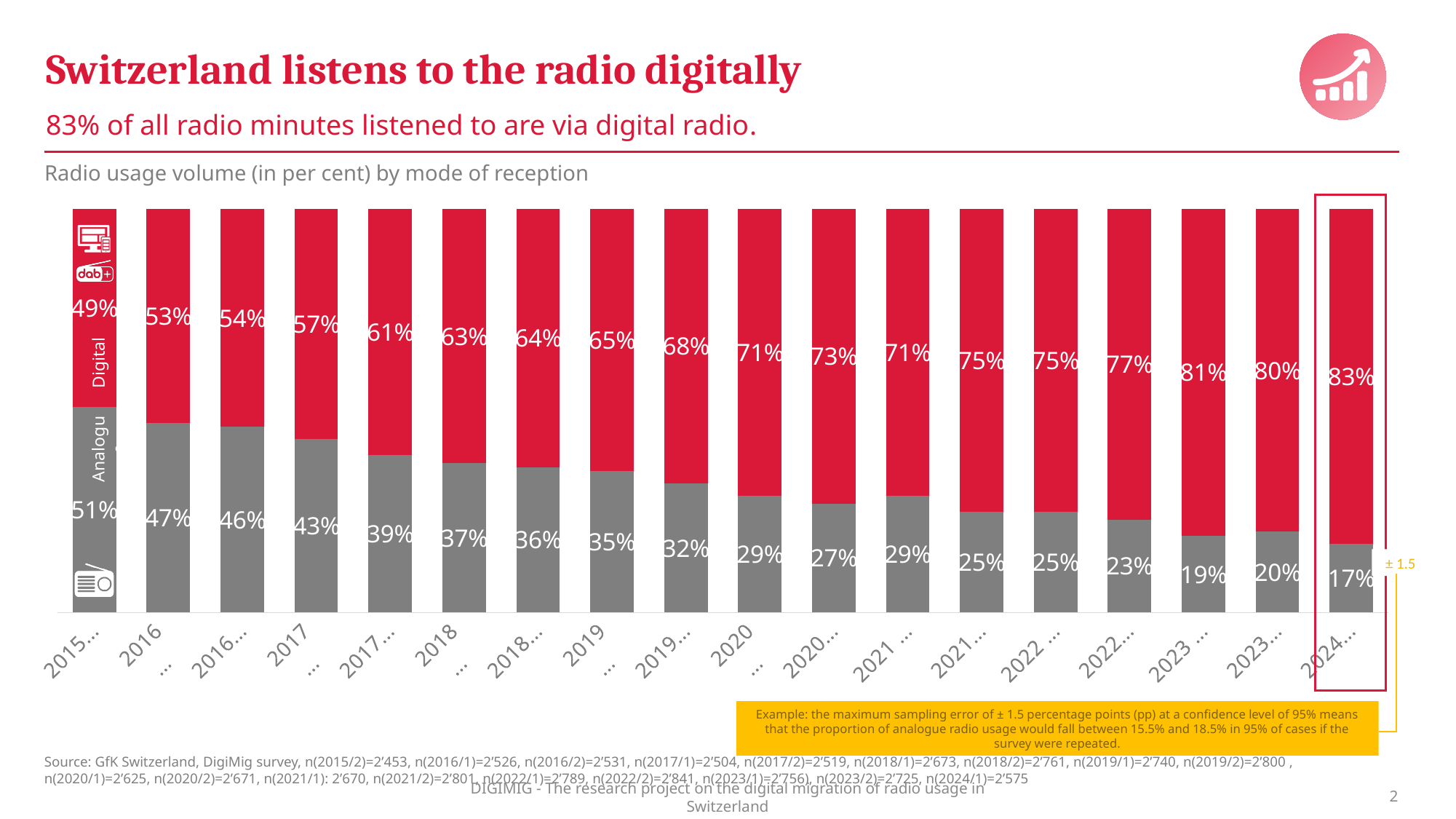
How many bars are plotted in the chart? 18 What colour represents the Digital series in the chart? Red Which bar has the highest Digital share? The last bar (2024), 83% Does the Digital share rise or fall from the first bar to the last bar? Rise Which bar has the lowest Analogue share? The last bar (2024), 17% In the last bar (2024), what is the difference between the Digital share and the Analogue share? 66 percentage points What is the Analogue share in the first bar (2015)? 51% What type of chart is shown on the slide? Stacked bar chart How many series does the chart show? 2 What is the Digital share in the last bar (2024)? 83% In the first bar (2015), which is larger: the Analogue share or the Digital share? Analogue What is the total of the stacked bar for 2024? 100%